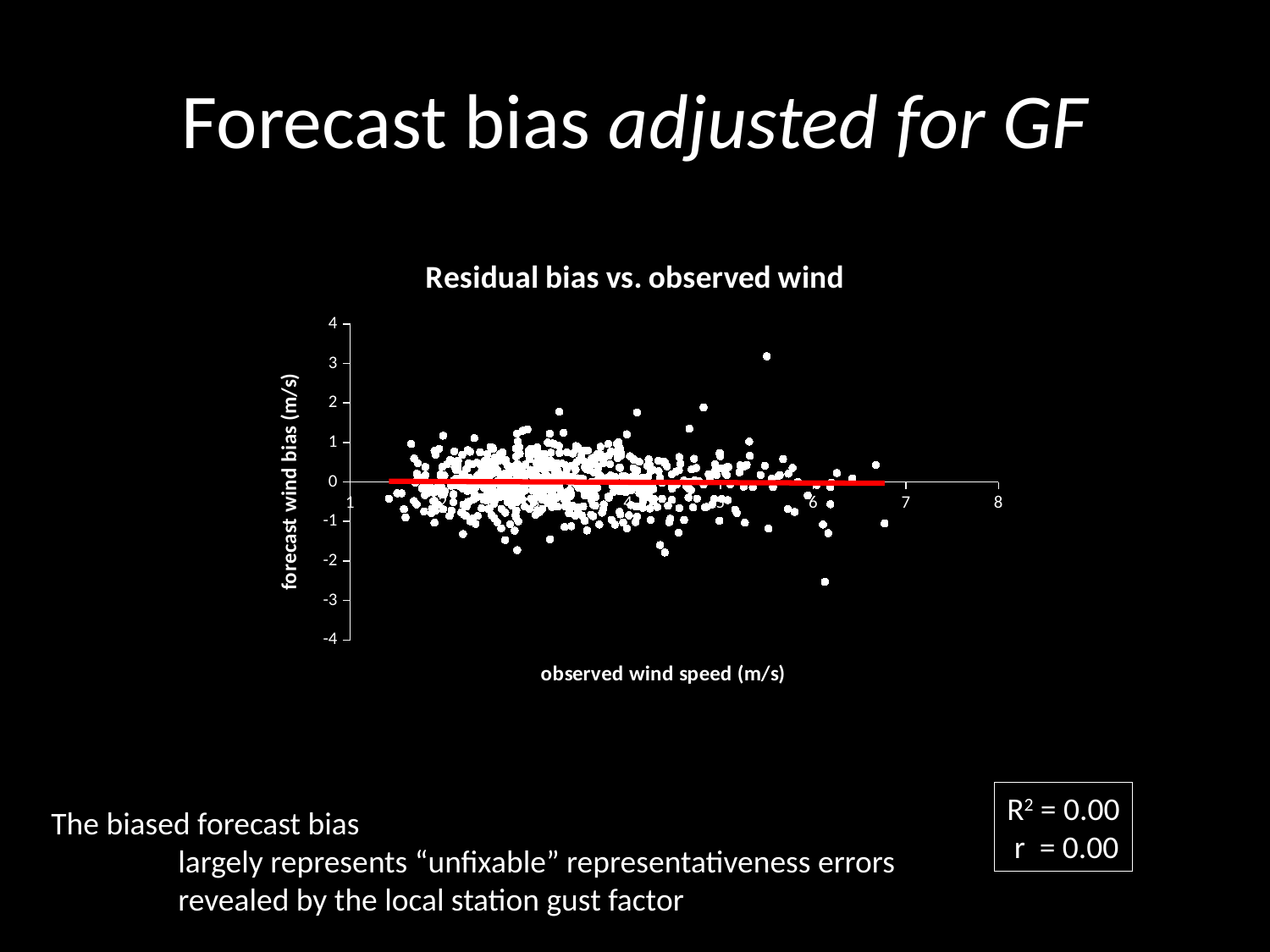
Is the lowest plotted point's forecast wind bias greater or less than -2? less Is the highest plotted point's forecast wind bias greater or less than 2? greater What is the label on the vertical axis of the chart? forecast wind bias (m/s) At what forecast wind bias value does the red fitted line sit? 0 What kind of chart is shown on the slide? scatter chart What is the title of the chart? Residual bias vs. observed wind Does the red fitted line rise, fall, or stay flat as observed wind speed increases? stays flat